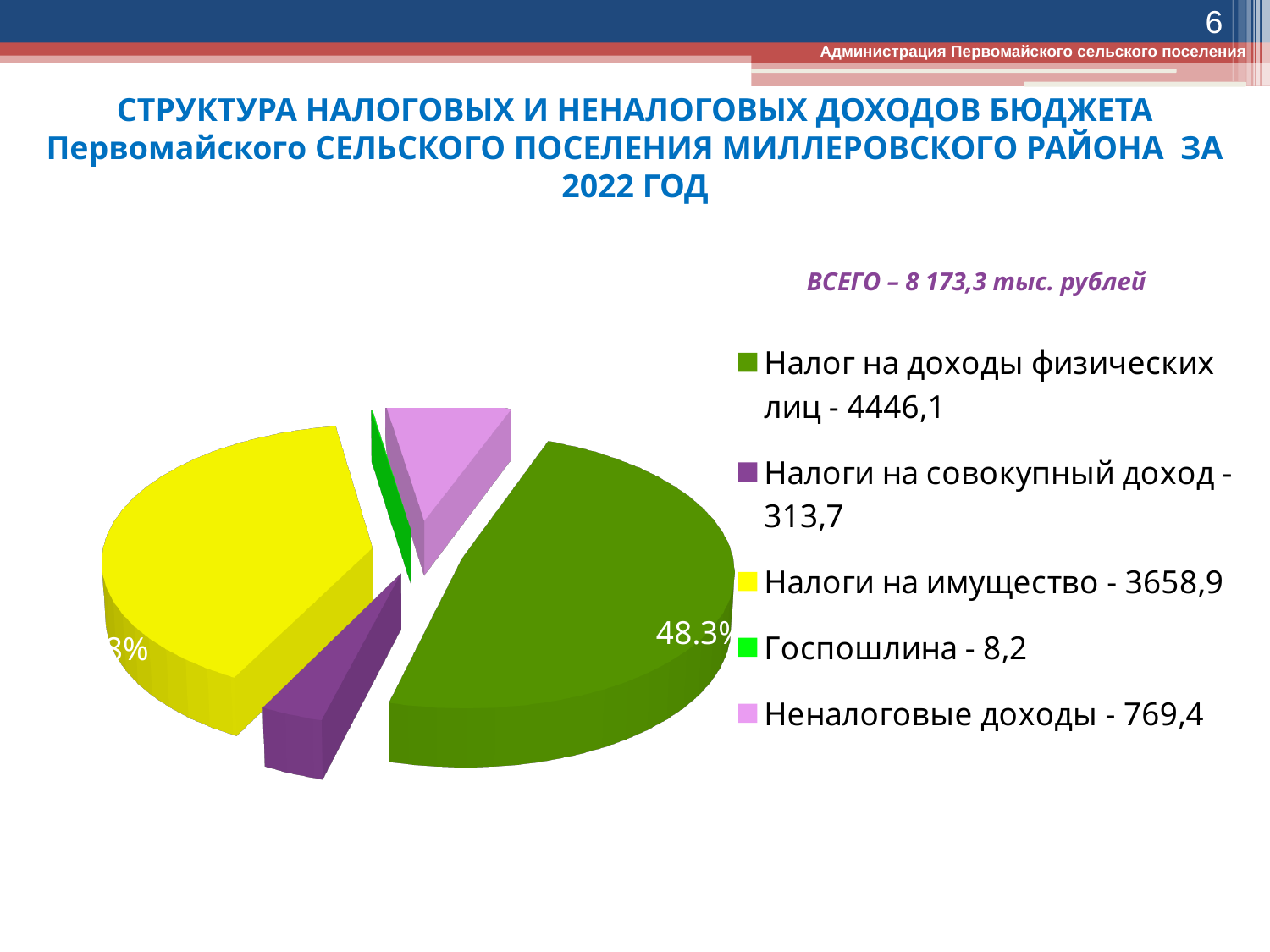
What percentage share is labelled on the slice for Налог на доходы физических лиц? 48.3% Which is larger: Неналоговые доходы or Налоги на совокупный доход? Неналоговые доходы What value does the legend give for Госпошлина? 8,2 What value does the legend give for Налог на доходы физических лиц? 4446,1 What total (ВСЕГО) is stated on the slide for the pie chart? 8 173,3 тыс. рублей Which category has the largest slice of the pie? Налог на доходы физических лиц How many categories does the legend of the pie chart list? 5 What value does the legend give for Налоги на имущество? 3658,9 What kind of chart is shown on the slide? pie chart Which category has the smallest slice of the pie? Госпошлина What value does the legend give for Неналоговые доходы? 769,4 What is the difference between the values for Налог на доходы физических лиц and Налоги на имущество? 787,2